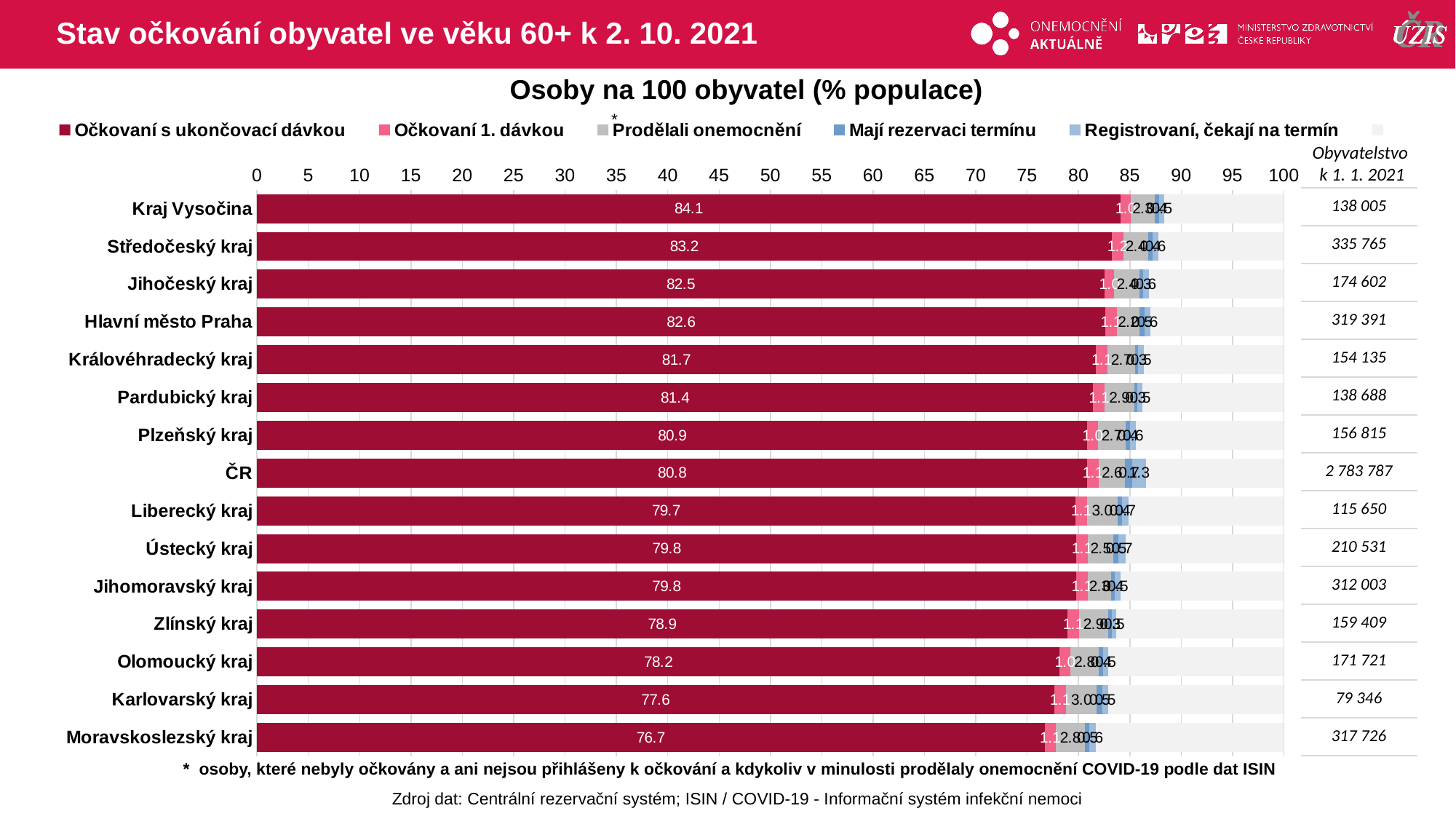
What is the value of "Očkovaní s ukončovací dávkou" for ČR? 80.8 What is the value of "Očkovaní s ukončovací dávkou" for Kraj Vysočina? 84.1 What is the value of "Očkovaní s ukončovací dávkou" for Pardubický kraj? 81.4 How many regions (categories) are shown in the chart? 15 What is the difference in "Očkovaní s ukončovací dávkou" between Středočeský kraj and Jihočeský kraj? 0.7 What is the difference in "Očkovaní s ukončovací dávkou" between Kraj Vysočina and Moravskoslezský kraj? 7.4 Which region has the highest value of "Očkovaní s ukončovací dávkou"? Kraj Vysočina Which region has the lowest value of "Očkovaní s ukončovací dávkou"? Moravskoslezský kraj What type of chart is shown on the slide? Bar chart Which has a higher value of "Očkovaní s ukončovací dávkou": Středočeský kraj or Karlovarský kraj? Středočeský kraj Is the value of "Očkovaní s ukončovací dávkou" for Karlovarský kraj greater or less than 80? less What is the value of "Očkovaní s ukončovací dávkou" for Moravskoslezský kraj? 76.7